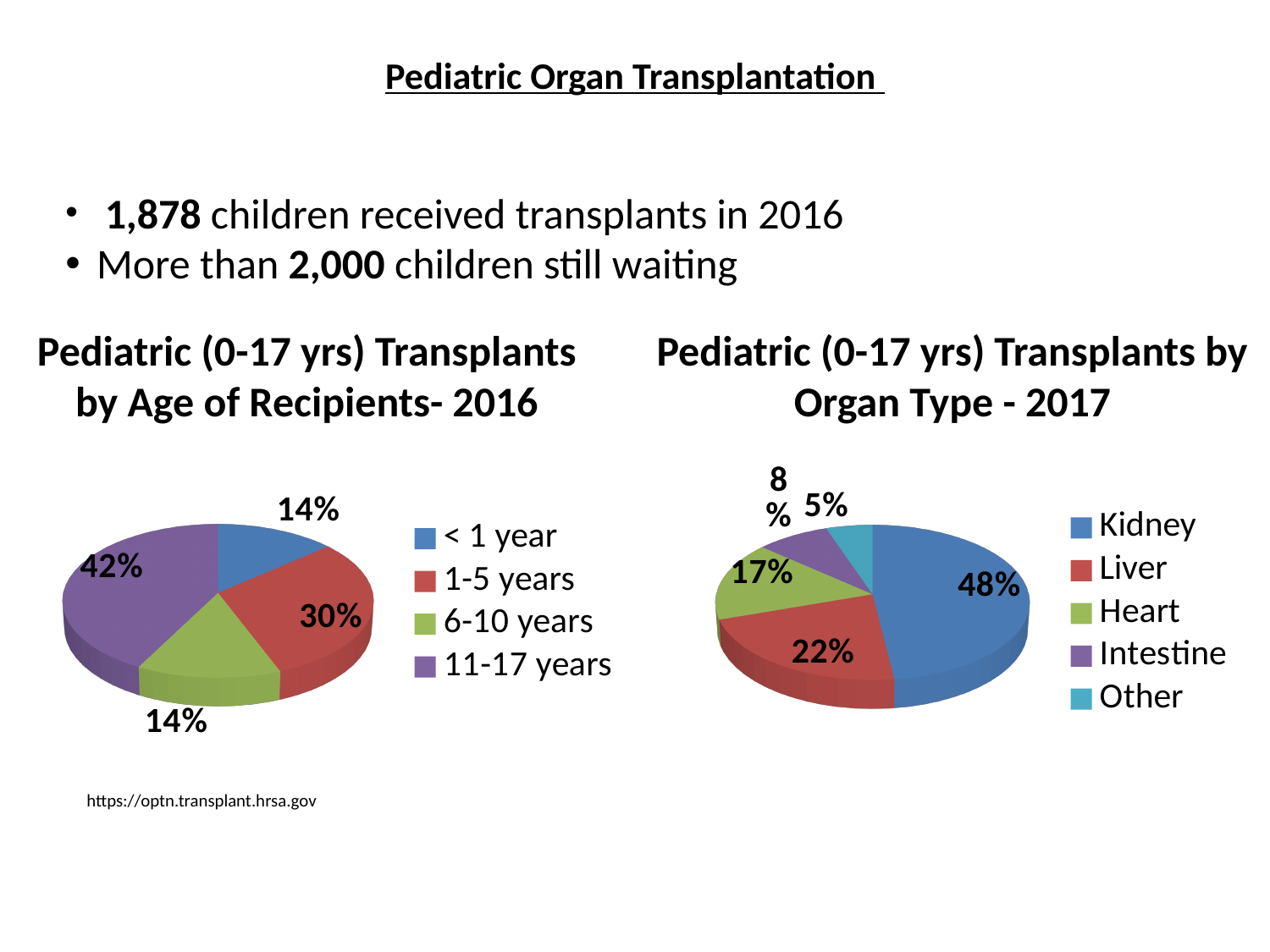
In the 'Pediatric (0-17 yrs) Transplants by Organ Type - 2017' chart, which is larger, the share for Liver or the share for Heart? Liver What type of chart is 'Pediatric (0-17 yrs) Transplants by Age of Recipients- 2016'? Pie chart In the 'Pediatric (0-17 yrs) Transplants by Age of Recipients- 2016' chart, what is the difference in percentage points between the 11-17 years and 1-5 years groups? 12 In the 'Pediatric (0-17 yrs) Transplants by Age of Recipients- 2016' chart, how many age groups are shown? 4 In the 'Pediatric (0-17 yrs) Transplants by Organ Type - 2017' chart, what is the difference in percentage points between Kidney and Liver? 26 In the 'Pediatric (0-17 yrs) Transplants by Organ Type - 2017' chart, what share of transplants were kidney transplants? 48% In the 'Pediatric (0-17 yrs) Transplants by Organ Type - 2017' chart, which organ type has the smallest share? Other In the 'Pediatric (0-17 yrs) Transplants by Age of Recipients- 2016' chart, what share of transplants went to recipients aged 11-17 years? 42% In the 'Pediatric (0-17 yrs) Transplants by Age of Recipients- 2016' chart, which age group has the largest share? 11-17 years In the 'Pediatric (0-17 yrs) Transplants by Organ Type - 2017' chart, what percentage is shown for Heart? 17% In the 'Pediatric (0-17 yrs) Transplants by Organ Type - 2017' chart, how many organ types does the legend list? 5 In the 'Pediatric (0-17 yrs) Transplants by Age of Recipients- 2016' chart, what percentage is shown for the 1-5 years group? 30%